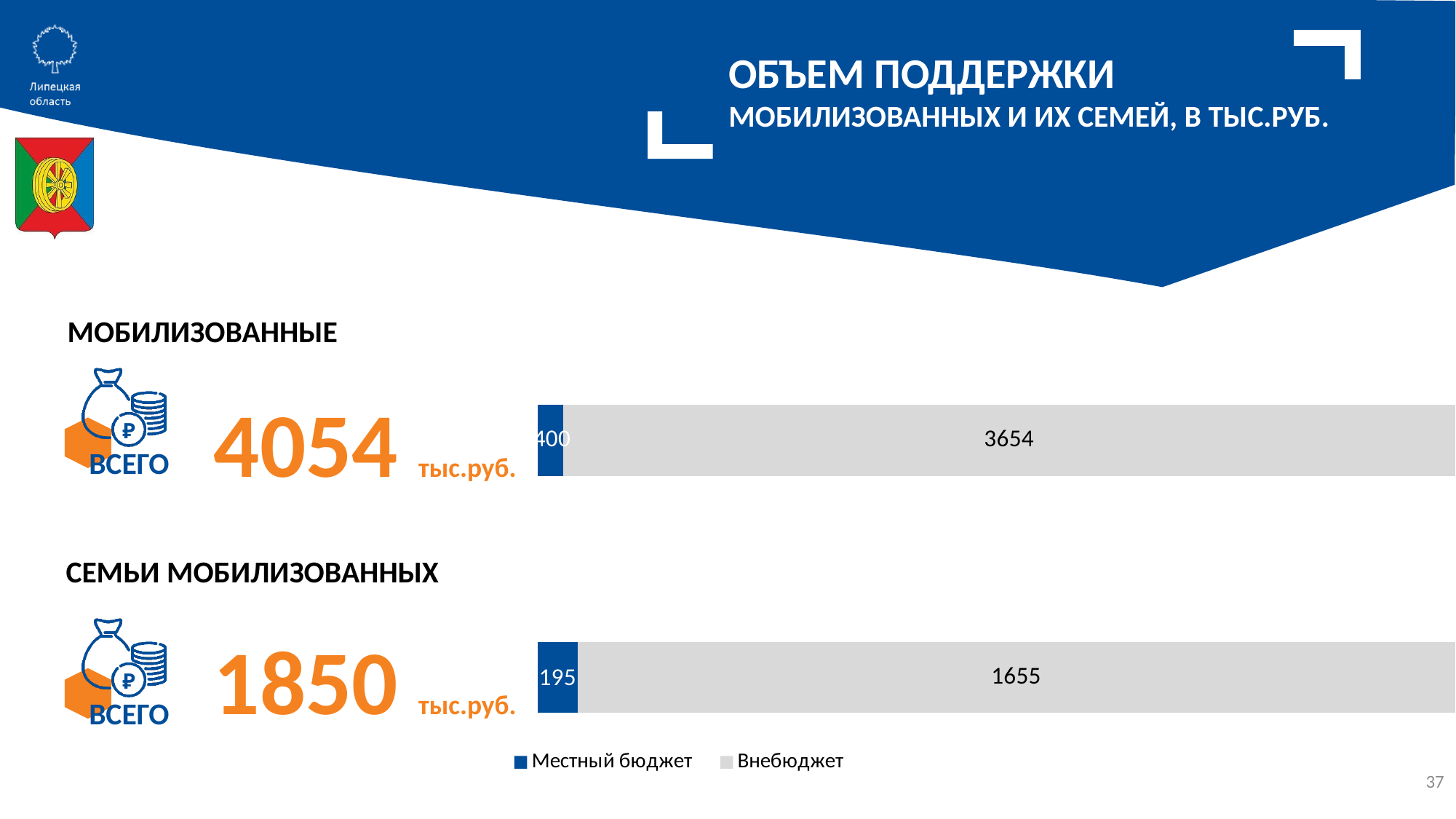
In the СЕМЬИ МОБИЛИЗОВАННЫХ bar, what is the value for Внебюджет? 1655 What kind of chart is shown on the slide? Stacked bar chart In the СЕМЬИ МОБИЛИЗОВАННЫХ bar, what is the value for Местный бюджет? 195 Which is larger: Местный бюджет for МОБИЛИЗОВАННЫЕ or Местный бюджет for СЕМЬИ МОБИЛИЗОВАННЫХ? МОБИЛИЗОВАННЫЕ How many series does the legend list? 2 In the СЕМЬИ МОБИЛИЗОВАННЫХ bar, what is the difference between Внебюджет and Местный бюджет? 1460 Which colour represents Внебюджет in the legend? Grey In the МОБИЛИЗОВАННЫЕ bar, what is the value for Внебюджет? 3654 In the МОБИЛИЗОВАННЫЕ bar, what is the difference between Внебюджет and Местный бюджет? 3254 What is the total of the СЕМЬИ МОБИЛИЗОВАННЫХ stacked bar? 1850 In the МОБИЛИЗОВАННЫЕ bar, what is the value for Местный бюджет? 400 What is the total of the МОБИЛИЗОВАННЫЕ stacked bar? 4054